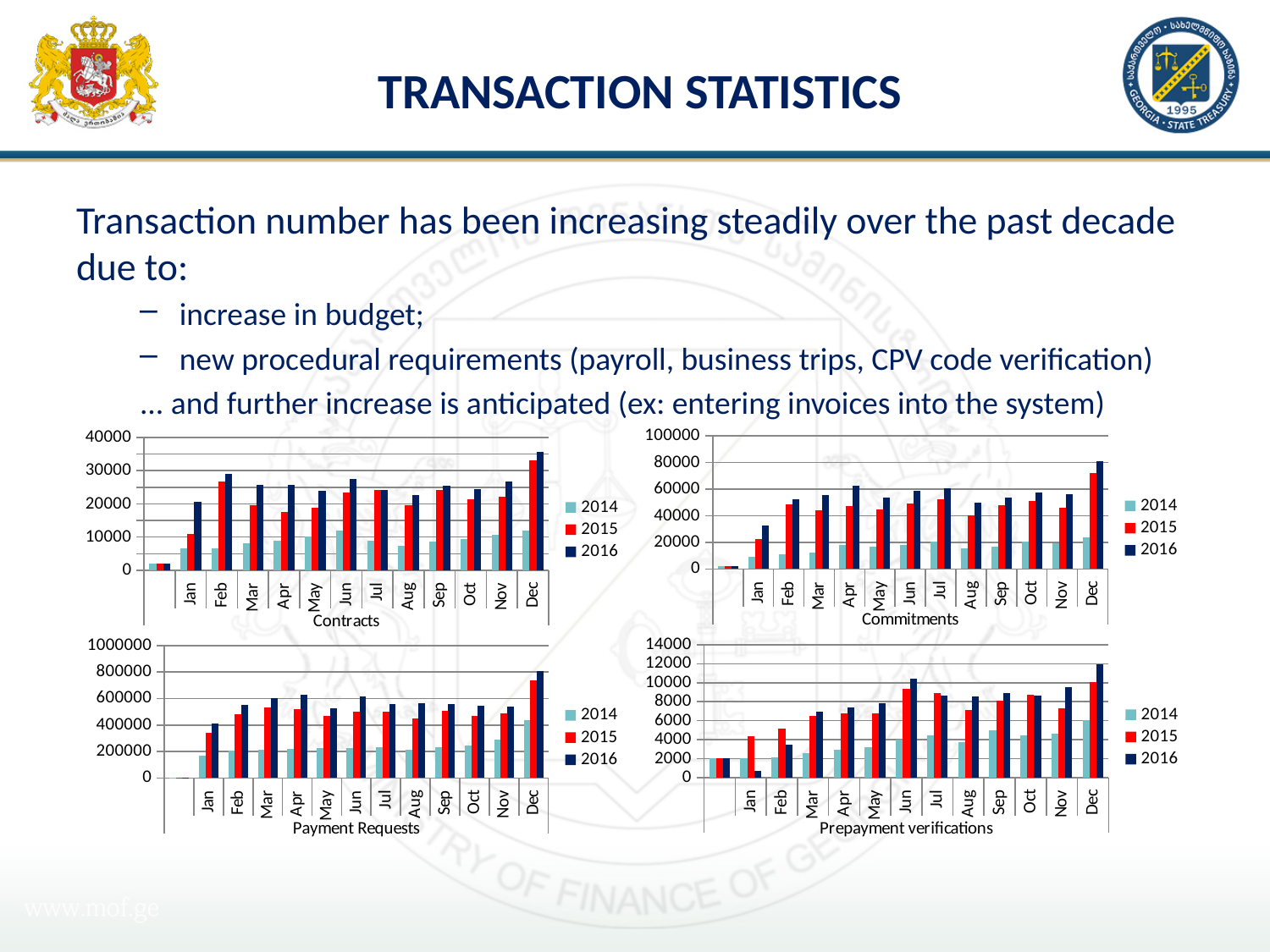
In the Commitments chart, which month has the highest 2016 value? Dec In the Contracts chart, which is larger for Jan: the 2015 value or the 2016 value? 2016 What kind of chart is the Contracts chart? bar chart In the Commitments chart, is the 2016 value for Dec greater or less than 60000? greater How many series does the legend of the Commitments chart list? 3 In the Payment Requests chart, do the 2014 values generally rise or fall from Jan to Dec? rise In the Prepayment verifications chart, is the 2016 value for Dec greater or less than 10000? greater How many months are shown on the x axis of the Payment Requests chart? 12 In the Payment Requests chart, is the 2015 value for Jan greater or less than 400000? less Which years are listed in the legend of the Prepayment verifications chart? 2014, 2015, 2016